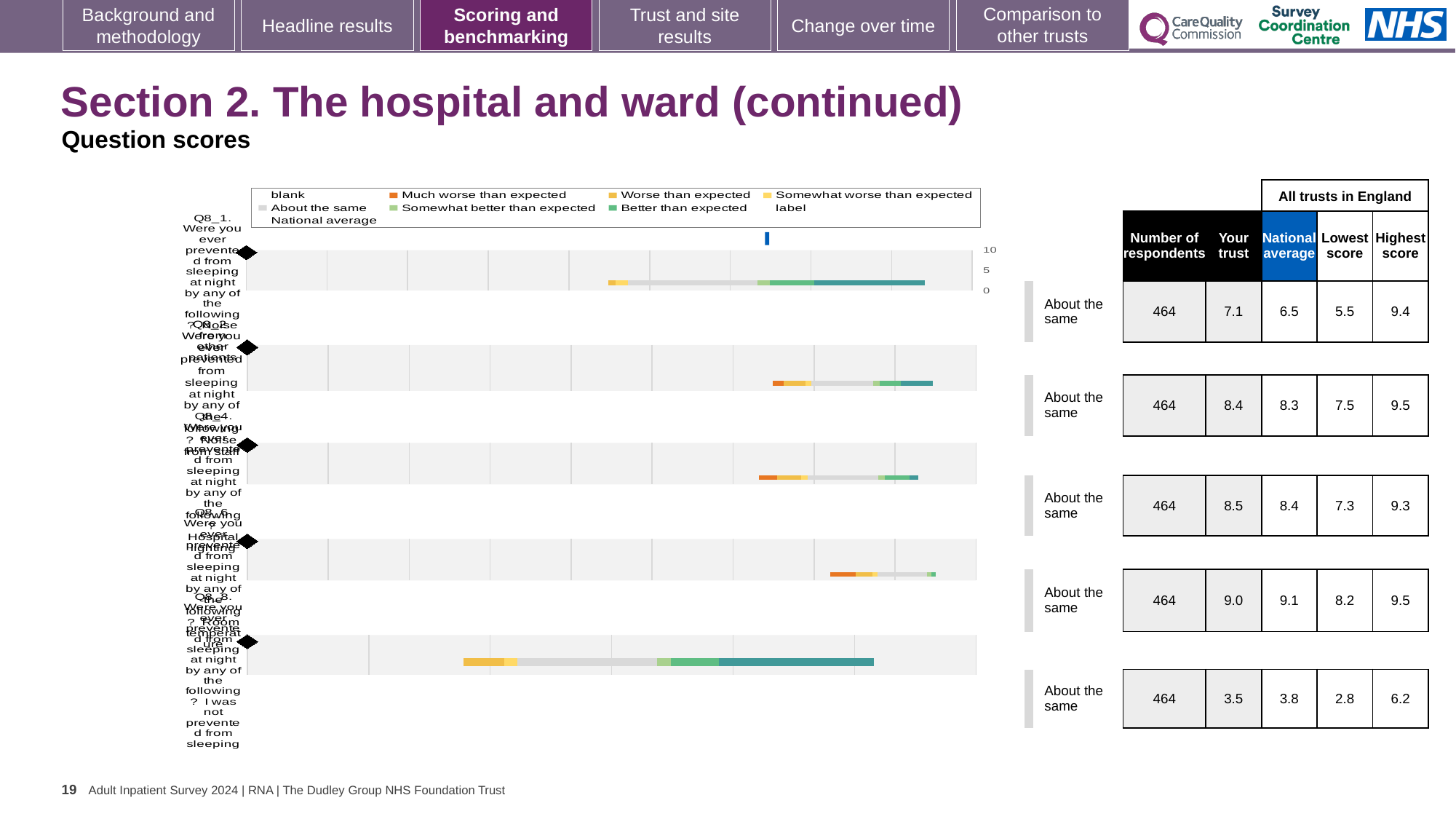
In the table to the right of the chart, which is larger for the first bar row: 'Your trust' (7.1) or 'National average' (6.5)? Your trust What is the highest tick value shown on the chart's axis? 10 In the table to the right of the chart, what is the number of respondents for each bar row? 464 In the table to the right of the chart, what is the 'Your trust' score for the last bar row (Q8_8)? 3.5 In the table to the right of the chart, what is the 'Your trust' score for the first bar row (Q8_1)? 7.1 In the table to the right of the chart, what is the difference between the highest score (9.4) and the lowest score (5.5) for the first bar row? 3.9 Which colour does the chart legend use for 'Much worse than expected'? orange How many horizontal bars (question rows) does the chart contain? 5 Which colour does the chart legend use for 'Better than expected'? teal What benchmark label is shown beside each bar row of the chart? About the same What kind of chart is shown on the slide? bar chart